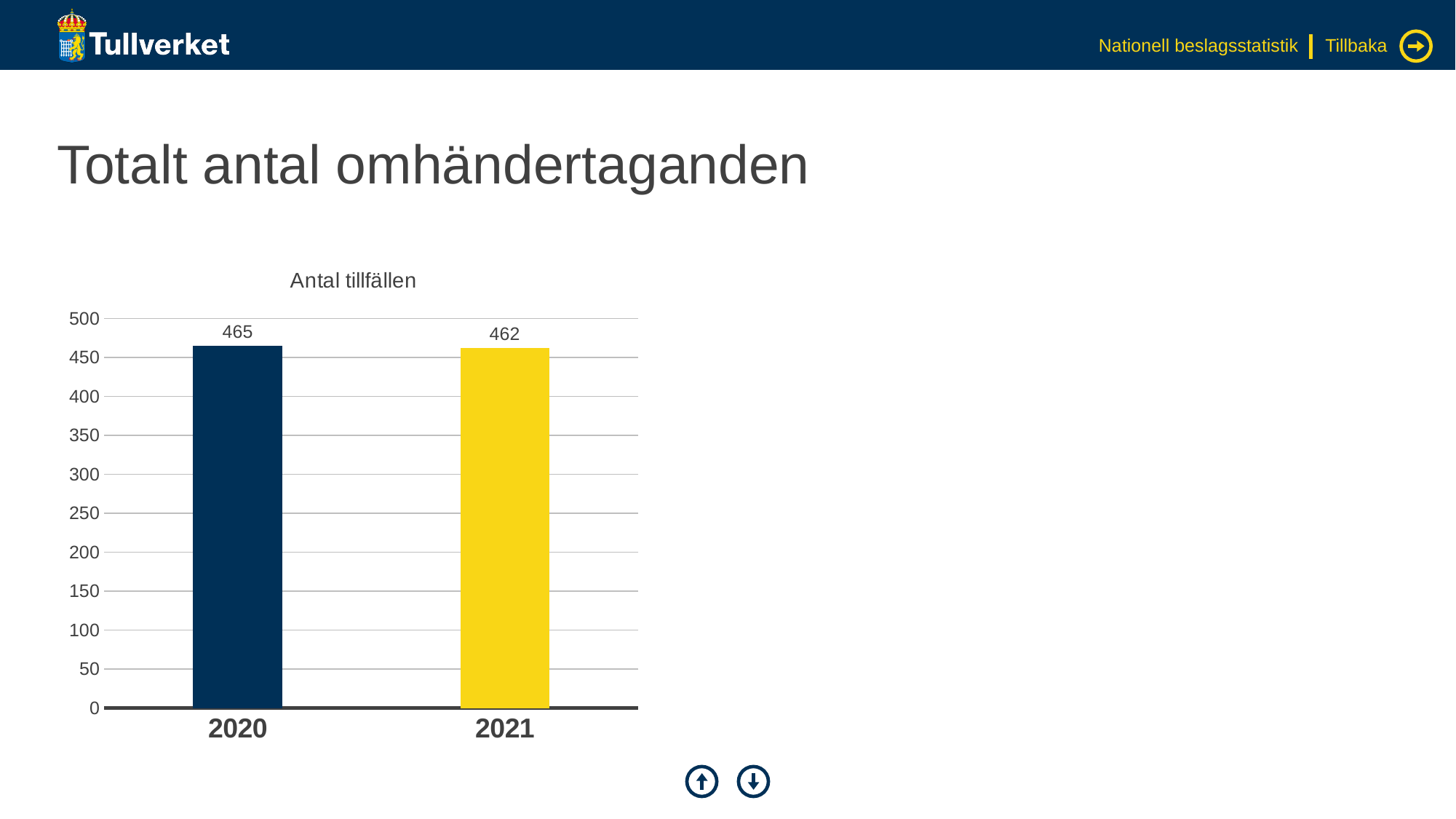
What is the difference between the values for 2020 and 2021? 3 Is the value for 2021 greater or less than 400? greater Do the values rise or fall from 2020 to 2021? fall Which year has the highest value? 2020 What is the value for 2021? 462 How many years are shown on the x axis? 2 What is the title of the chart? Antal tillfällen What kind of chart is shown? bar chart Which is larger, the value for 2020 or the value for 2021? 2020 What is the value for 2020? 465 Is the value for 2020 greater or less than 500? less Which year has the lowest value? 2021